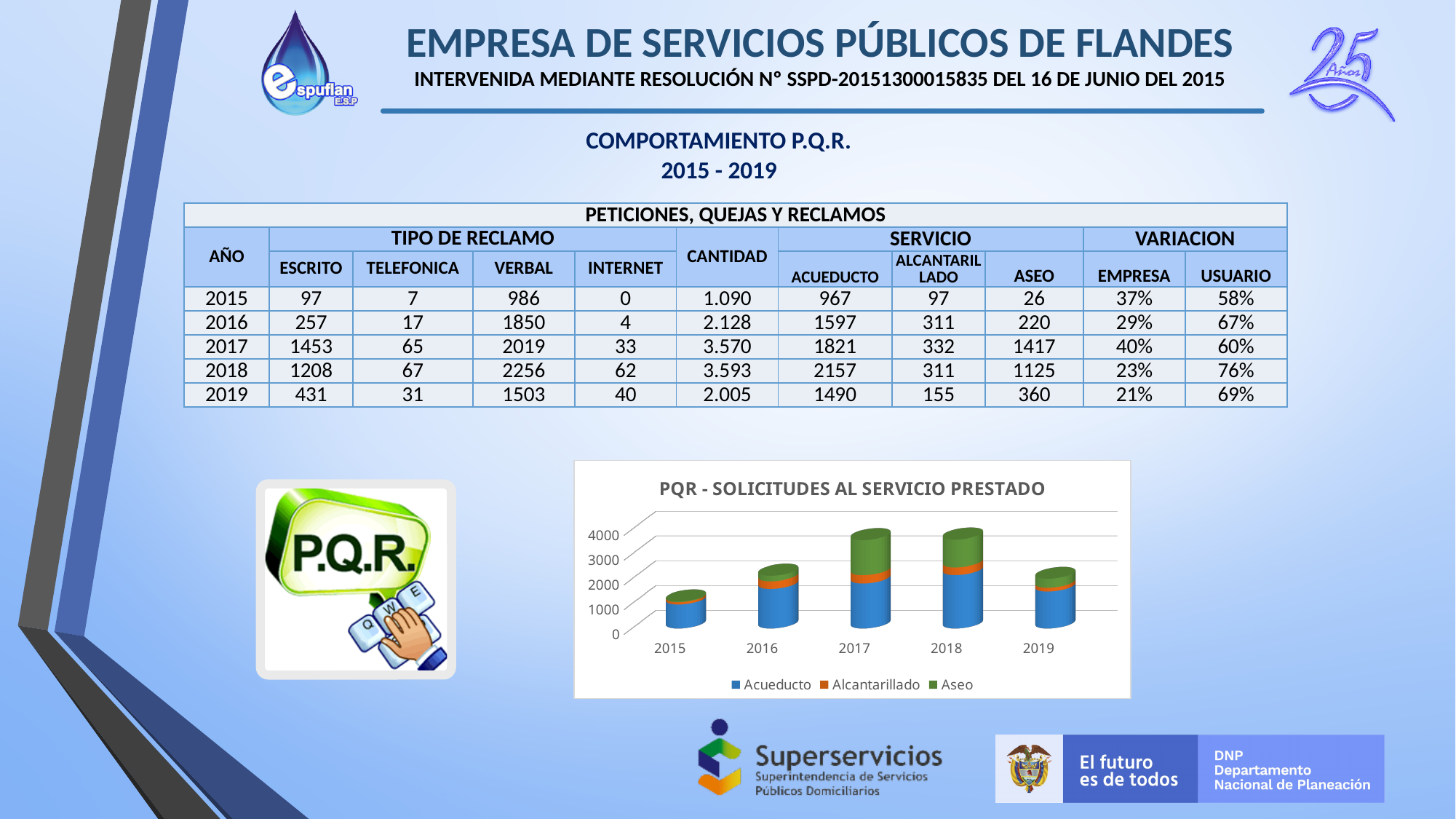
In the 'PQR - SOLICITUDES AL SERVICIO PRESTADO' chart, is the total bar for 2017 greater or less than 3000? greater How many series does the legend of the 'PQR - SOLICITUDES AL SERVICIO PRESTADO' chart list? 3 Which year has the lowest total bar in the 'PQR - SOLICITUDES AL SERVICIO PRESTADO' chart? 2015 In the 'PQR - SOLICITUDES AL SERVICIO PRESTADO' chart, is the total bar for 2019 greater or less than 3000? less Which colour represents Aseo in the 'PQR - SOLICITUDES AL SERVICIO PRESTADO' chart? Green What kind of chart is 'PQR - SOLICITUDES AL SERVICIO PRESTADO'? Stacked bar chart In the 'PQR - SOLICITUDES AL SERVICIO PRESTADO' chart, do the total bars rise or fall from 2015 to 2018? rise In the 'PQR - SOLICITUDES AL SERVICIO PRESTADO' chart, is the total bar for 2015 greater or less than 2000? less How many years are shown on the x axis of the 'PQR - SOLICITUDES AL SERVICIO PRESTADO' chart? 5 In the 'PQR - SOLICITUDES AL SERVICIO PRESTADO' chart, which total bar is larger, 2016 or 2017? 2017